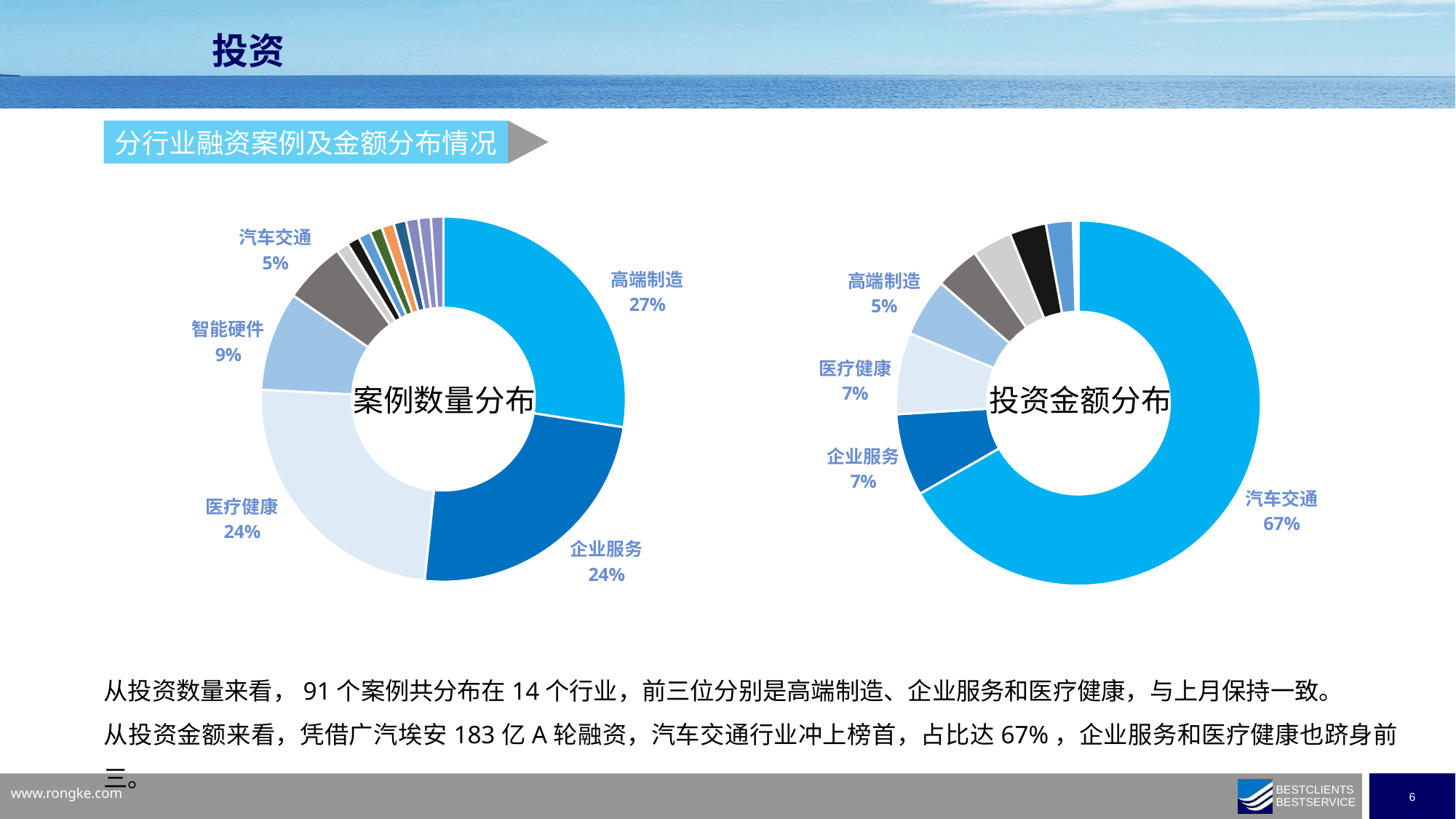
In the 投资金额分布 chart on the right, which category has the largest share? 汽车交通 In the 案例数量分布 chart on the left, what share does 高端制造 have? 27% In the 投资金额分布 chart on the right, what share does 高端制造 have? 5% In the 案例数量分布 chart on the left, what share does 智能硬件 have? 9% In the 投资金额分布 chart on the right, what share does 汽车交通 have? 67% In the 案例数量分布 chart on the left, which labelled category has the largest share? 高端制造 In the 案例数量分布 chart on the left, what is the difference in percentage points between 高端制造 and 智能硬件? 18 Which is larger in the 案例数量分布 chart on the left: the share of 智能硬件 or the share of 汽车交通? 智能硬件 What is the title shown in the centre of the left chart? 案例数量分布 What kind of chart is the 投资金额分布 chart on the right? Donut (pie) chart In the 投资金额分布 chart on the right, what is the difference in percentage points between 汽车交通 and 企业服务? 60 In the 案例数量分布 chart on the left, what share does 汽车交通 have? 5%